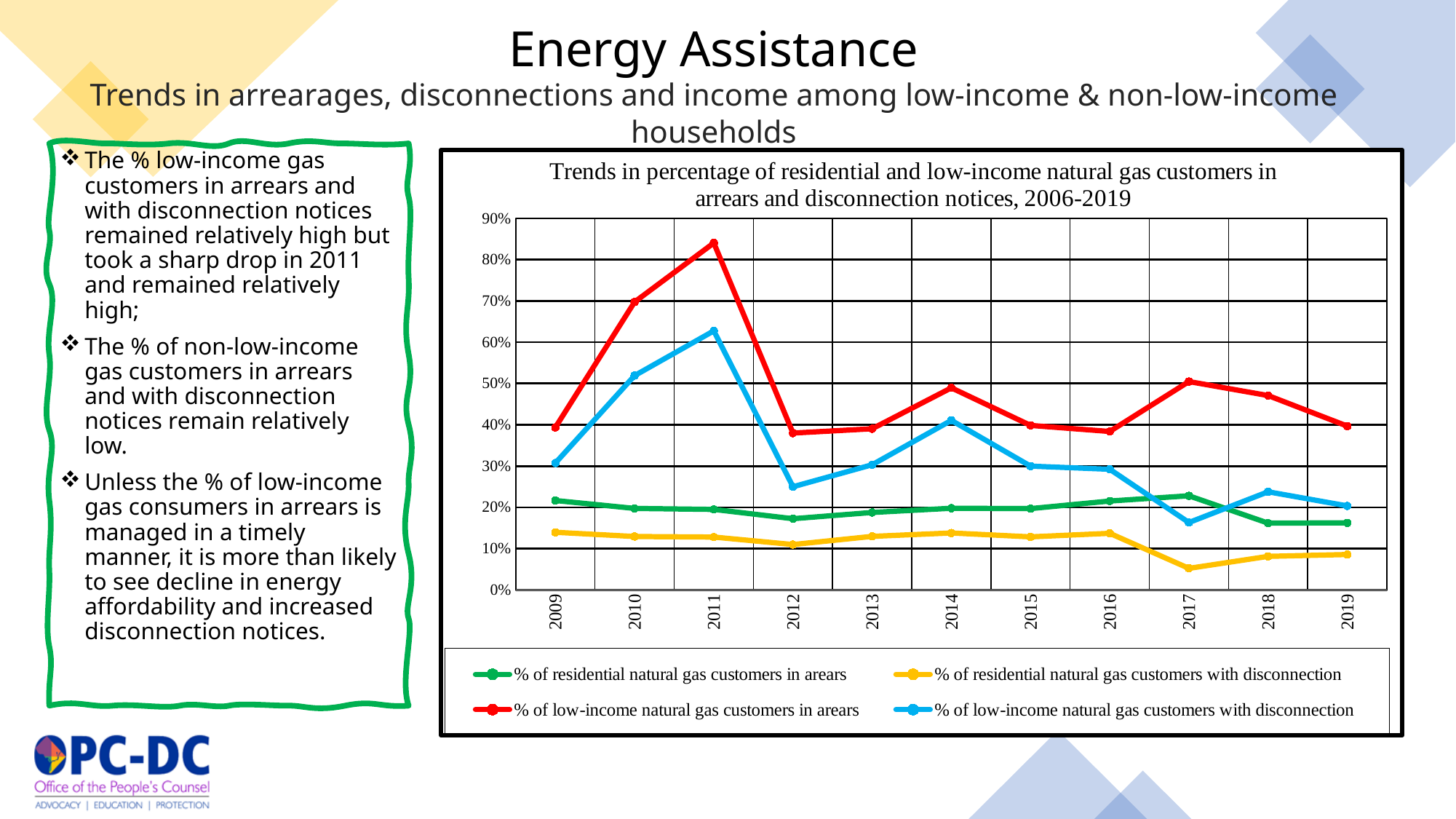
How many series does the chart's legend list? 4 Is the value for % of low-income natural gas customers in arrears in 2011 greater or less than 80%? greater How many years are plotted along the x axis of the chart? 11 In which year is the % of residential natural gas customers with disconnection lowest? 2017 What colour is the line for % of low-income natural gas customers with disconnection? blue What kind of chart is shown on the slide? line chart In which year is the % of low-income natural gas customers in arrears highest? 2011 In which year is the % of low-income natural gas customers with disconnection highest? 2011 In 2017, which is larger: the % of residential natural gas customers in arears or the % of low-income natural gas customers with disconnection? % of residential natural gas customers in arears Is the value for % of low-income natural gas customers with disconnection in 2012 greater or less than 30%? less Does the % of low-income natural gas customers in arrears rise or fall from 2017 to 2019? fall Is the value for % of residential natural gas customers in arears in 2012 greater or less than 20%? less